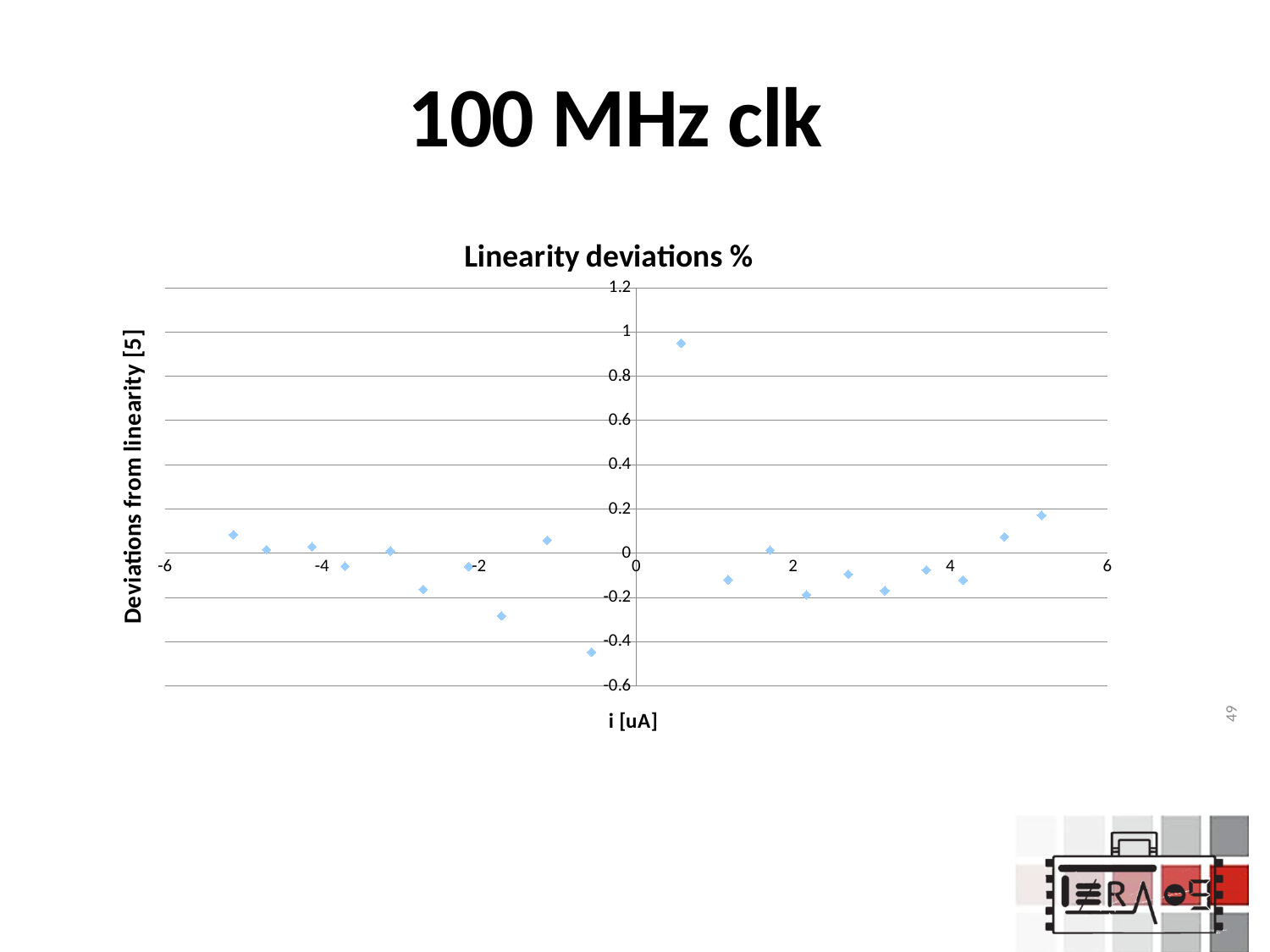
Is the point just to the right of x = 0 higher or lower than the point just to the left of x = 0? higher What is the highest value shown on the y axis of the chart? 1.2 Is the point at about x = 5 on the chart greater or less than 0? greater What is the label of the x axis of the chart? i [uA] Is the value of the lowest point on the chart greater or less than -0.4? less Is the value of the highest point on the chart greater or less than 0.8? greater What kind of chart is shown on the slide? scatter chart What is the title of the chart? Linearity deviations % How many points on the chart have a value less than -0.4? 1 How many points on the chart have a value greater than 0.4? 1 What is the lowest value shown on the y axis of the chart? -0.6 What is the largest value shown on the x axis of the chart? 6